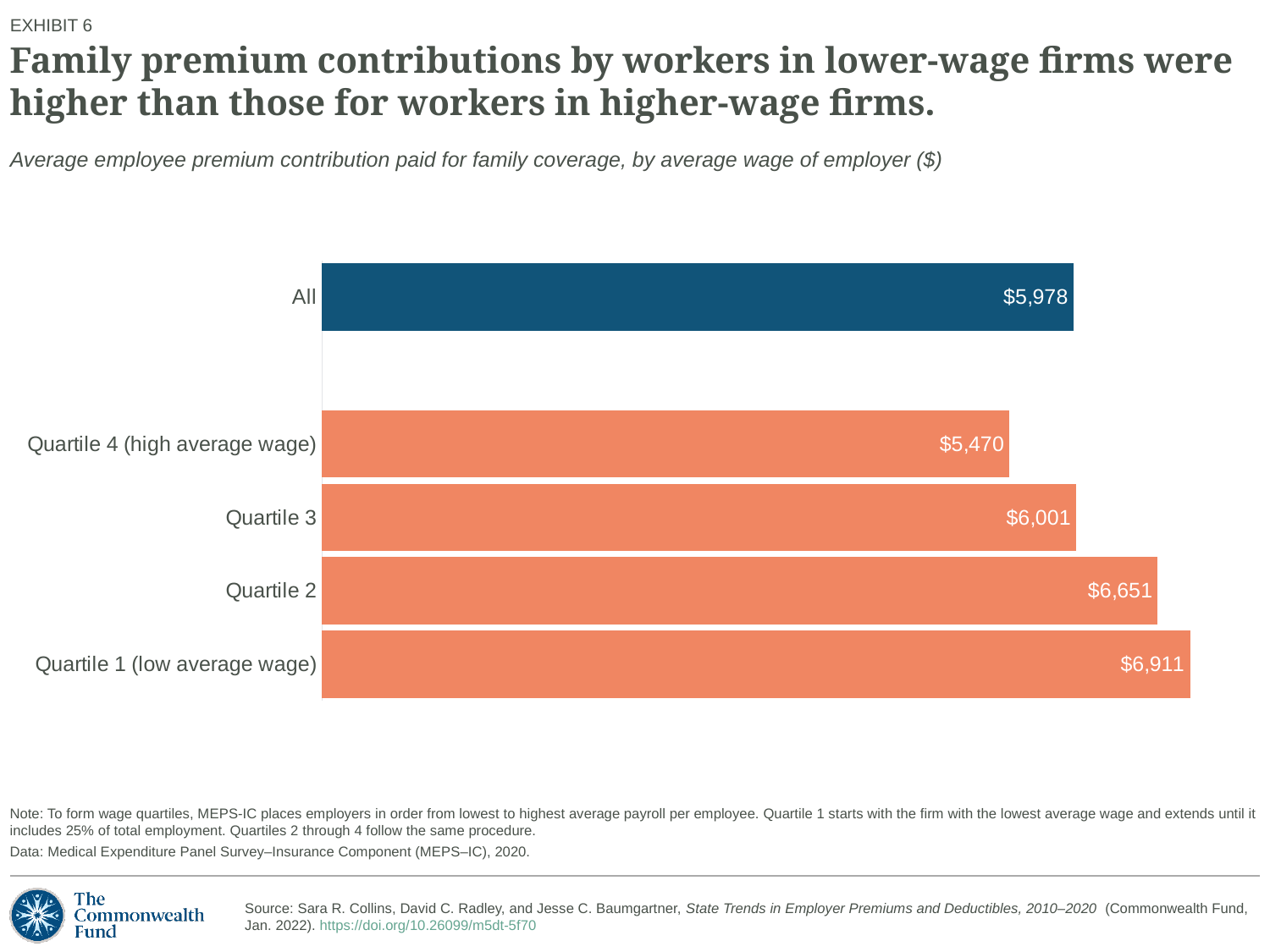
Which category has the highest average employee premium contribution? Quartile 1 (low average wage) What is the value shown for Quartile 4 (high average wage)? $5,470 How many bars are shown in the chart? 5 What is the average employee premium contribution for family coverage for Quartile 1 (low average wage)? $6,911 What is the difference between the values for Quartile 1 (low average wage) and Quartile 4 (high average wage)? $1,441 What is the value shown for Quartile 3? $6,001 Which is larger, the value for Quartile 2 or the value for Quartile 3? Quartile 2 Which category has the lowest average employee premium contribution? Quartile 4 (high average wage) Which bar is shown in a different colour (dark blue) from the others? All What kind of chart is shown on the slide? Bar chart What is the value shown for the 'All' bar? $5,978 What is the difference between the values for Quartile 2 and Quartile 3? $650